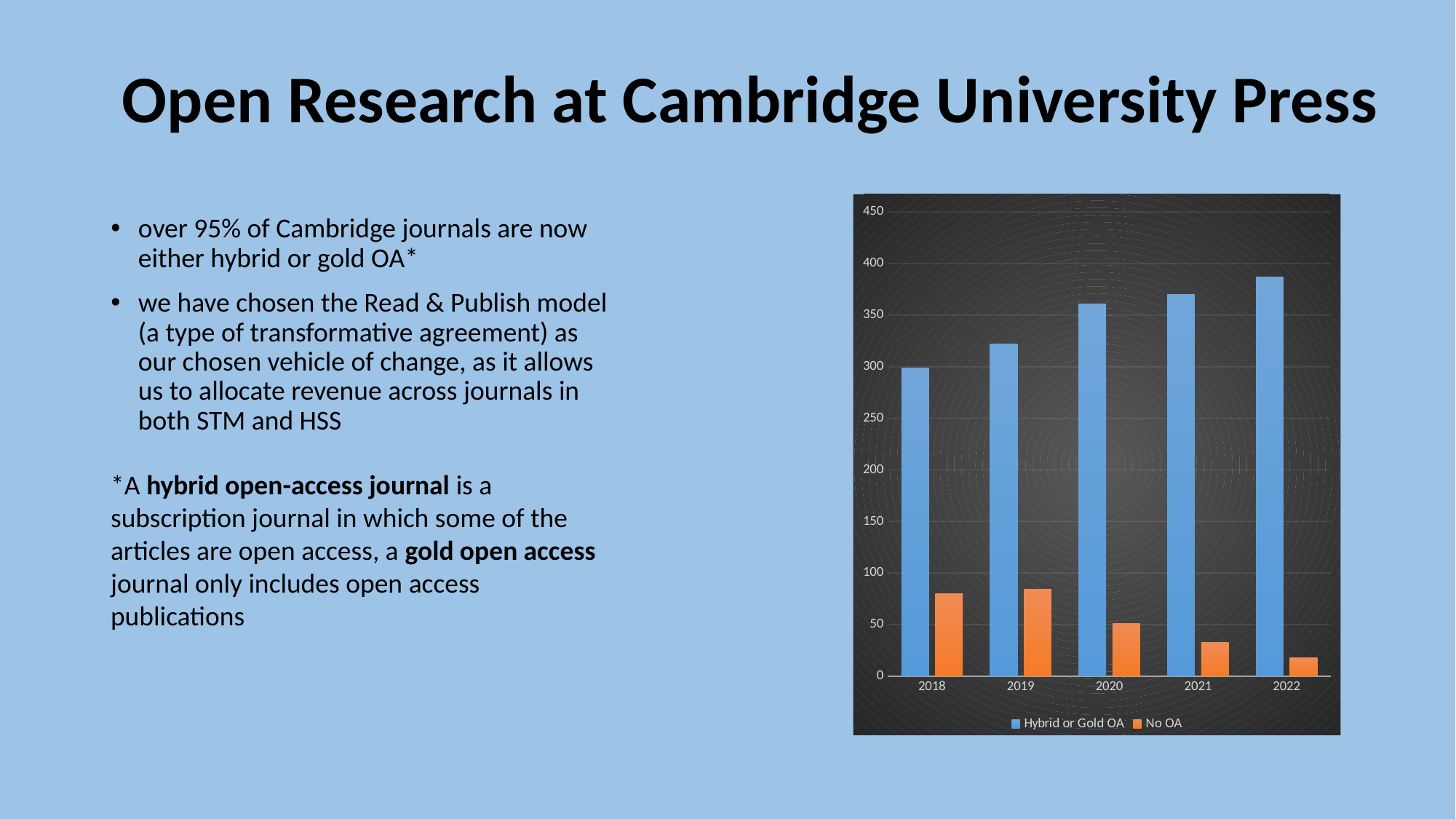
Do the Hybrid or Gold OA values rise or fall from 2018 to 2022? rise Is the value for Hybrid or Gold OA in 2019 greater or less than 300? greater How many years are shown on the x axis of the chart? 5 Which year has the lowest value for No OA? 2022 Is the value for Hybrid or Gold OA in 2022 greater or less than 350? greater How many series does the chart legend list? 2 Which year has the highest value for Hybrid or Gold OA? 2022 Which is larger: the No OA value in 2020 or in 2021? 2020 Which colour represents the No OA series in the chart? orange Which year has the lowest value for Hybrid or Gold OA? 2018 What kind of chart is shown on the slide? bar chart Is the value for No OA in 2020 greater or less than 100? less